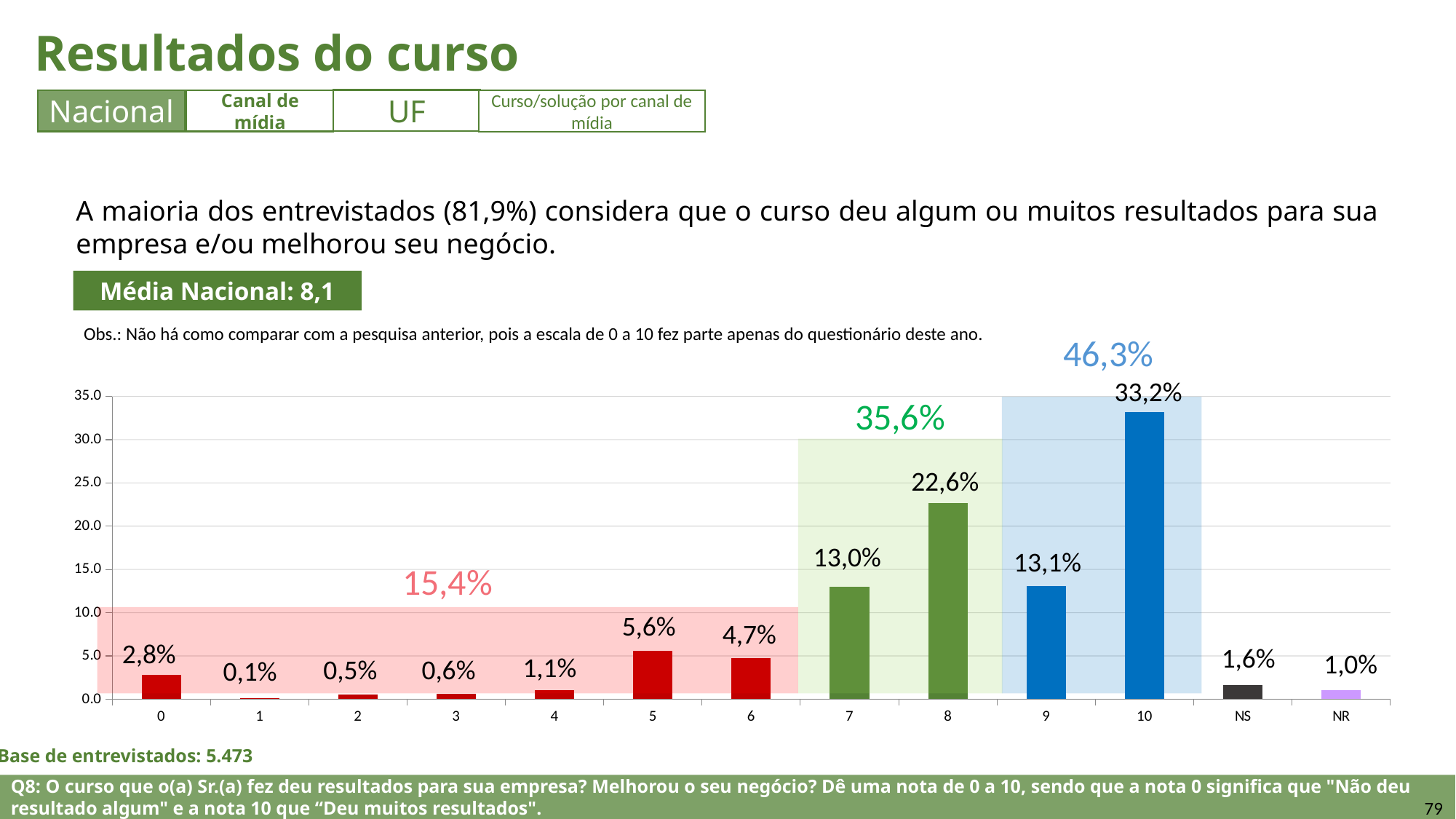
How many categories are shown on the x axis? 13 What percentage of respondents gave a score of 10? 33,2% What is the value shown for the score of 8? 22,6% What is the value for the score of 5? 5,6% What combined percentage is shown above the green-shaded group (scores 7 and 8)? 35,6% Is the value for score 8 greater or less than 20.0? greater What kind of chart is shown on the slide? bar chart Which category has the lowest value? 1 What percentage is shown for the NS category? 1,6% Which is larger, the value for score 6 or the value for score 7? 7 Which category has the highest value? 10 What is the difference between the values for scores 10 and 8? 10,6 percentage points